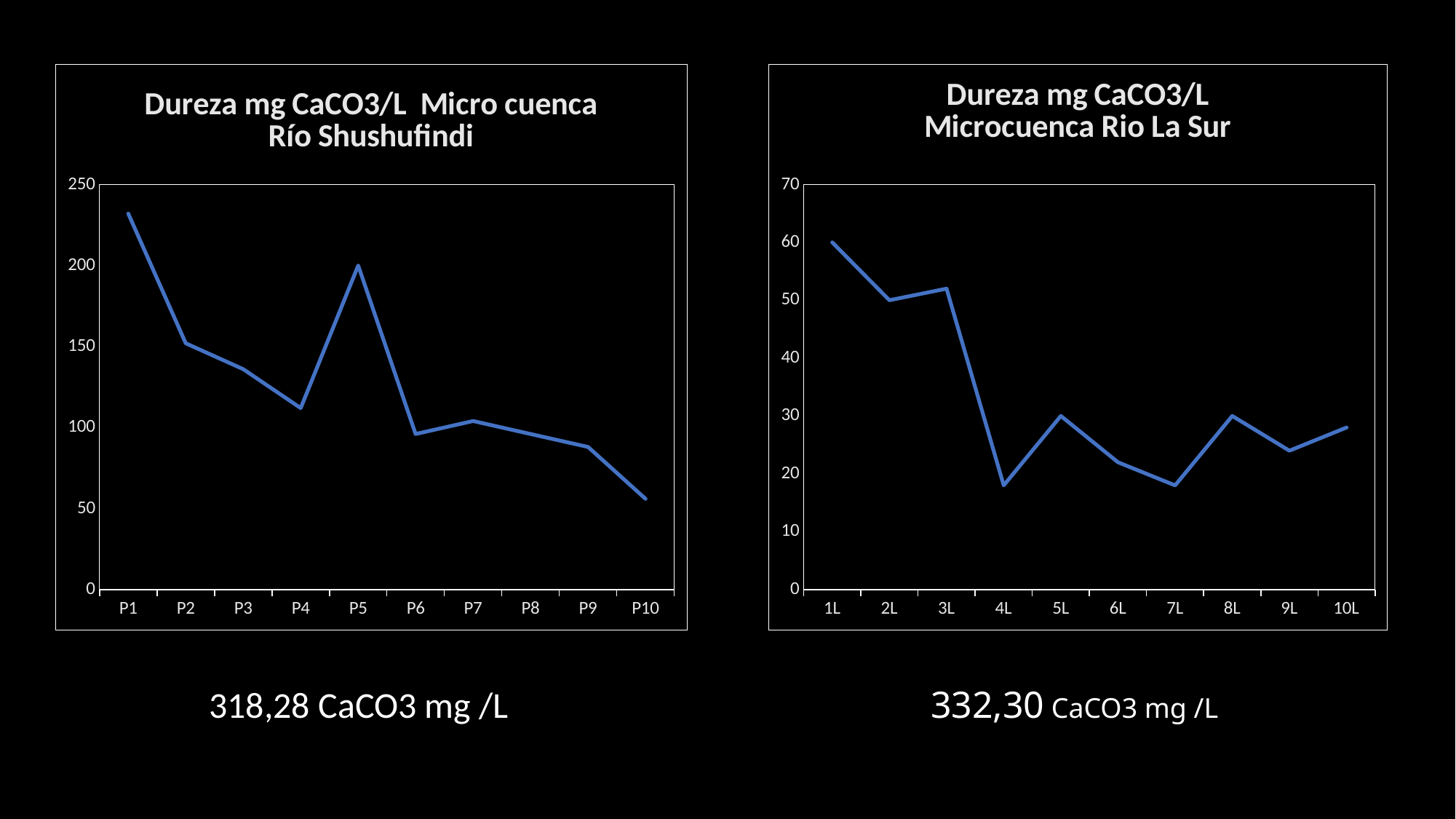
In the left chart (Río Shushufindi), is the value for P10 greater or less than 100? less In the right chart (Microcuenca Rio La Sur), is the value for 1L greater or less than 50? greater In the left chart (Río Shushufindi), which is larger, the value for P1 or the value for P5? P1 In the right chart (Microcuenca Rio La Sur), which point has the highest hardness value? 1L What is the maximum value shown on the y axis of the right chart (Microcuenca Rio La Sur)? 70 In the left chart (Río Shushufindi), which point has the highest hardness value? P1 In the right chart (Microcuenca Rio La Sur), which is larger, the value for 3L or the value for 4L? 3L In the right chart (Microcuenca Rio La Sur), how many points are plotted along the x axis? 10 In the left chart (Río Shushufindi), is the value for P1 greater or less than 200? greater What kind of chart is the 'Dureza mg CaCO3/L Micro cuenca Río Shushufindi' chart on the left? Line chart In the left chart (Río Shushufindi), how many points are plotted along the x axis? 10 In the left chart (Río Shushufindi), which point has the lowest hardness value? P10